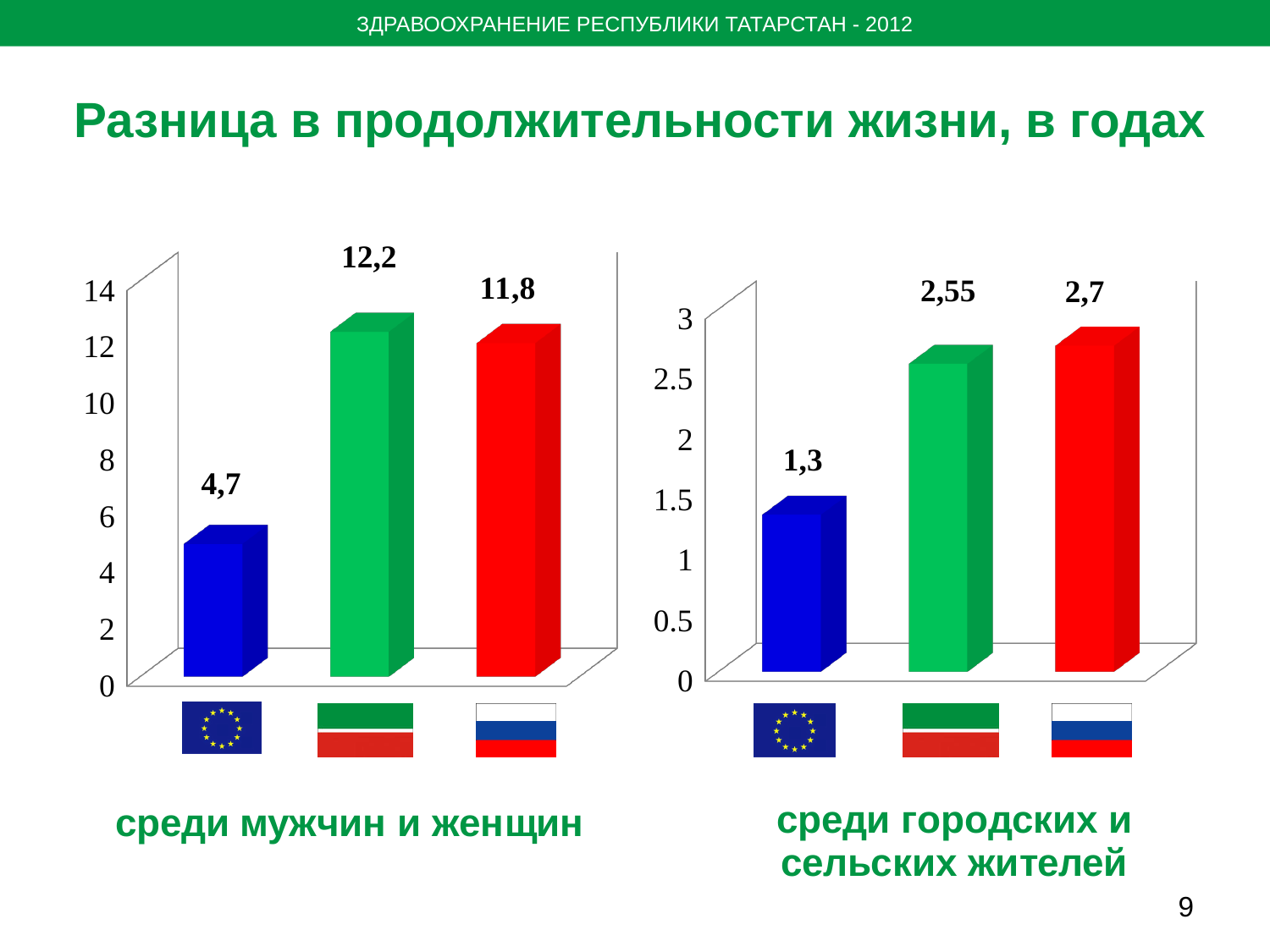
On the right chart (среди городских и сельских жителей), which bar is the lowest? The blue bar on the left (1,3) How many bars does the right chart (среди городских и сельских жителей) show? 3 On the left chart (среди мужчин и женщин), which is larger: the green bar or the red bar? The green bar (12,2) On the left chart (среди мужчин и женщин), what is the difference between the green bar and the blue bar? 7,5 On the left chart (среди мужчин и женщин), what is the value of the blue bar on the left? 4,7 What type of chart is used on this slide? Bar chart On the right chart (среди городских и сельских жителей), what is the difference between the red bar and the blue bar? 1,4 On the left chart (среди мужчин и женщин), which bar is the highest? The green middle bar (12,2) On the left chart (среди мужчин и женщин), what is the difference between the green bar and the red bar? 0,4 On the right chart (среди городских и сельских жителей), what is the value of the green middle bar? 2,55 On the right chart (среди городских и сельских жителей), which bar is the highest? The red bar on the right (2,7) On the left chart (среди мужчин и женщин), what is the value of the green middle bar? 12,2